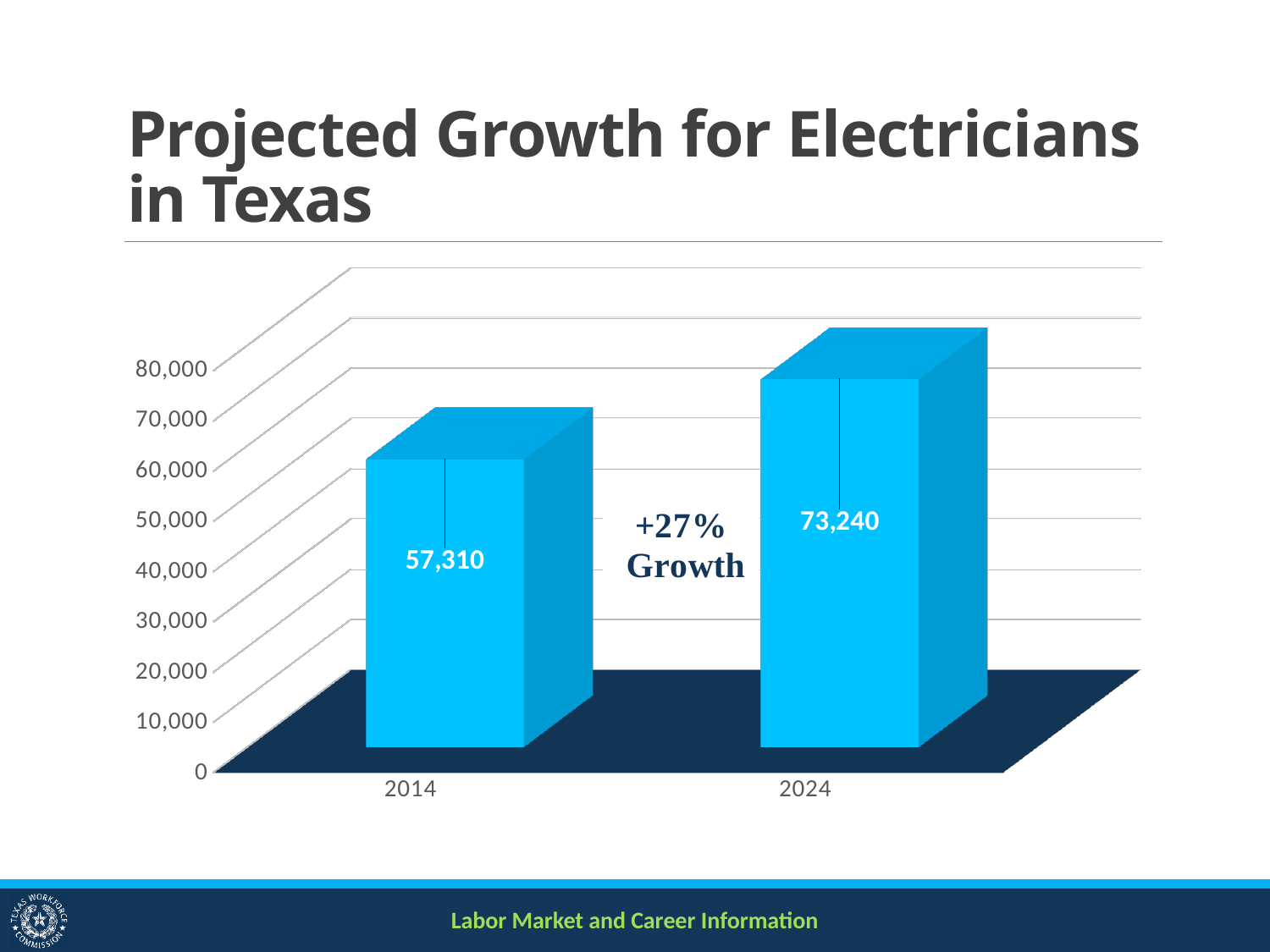
What kind of chart is shown on the slide? bar chart Which year has the higher value? 2024 What is the difference between the 2024 value and the 2014 value? 15,930 What is the value for 2014? 57,310 Is the value for 2014 greater or less than 60,000? less How many categories are shown on the x axis? 2 What is the value for 2024? 73,240 Is the value for 2014 larger or smaller than the value for 2024? smaller Which year has the lower value? 2014 Do the values rise or fall from 2014 to 2024? rise Is the value for 2024 greater or less than 70,000? greater What percentage growth is annotated between the two bars? +27%